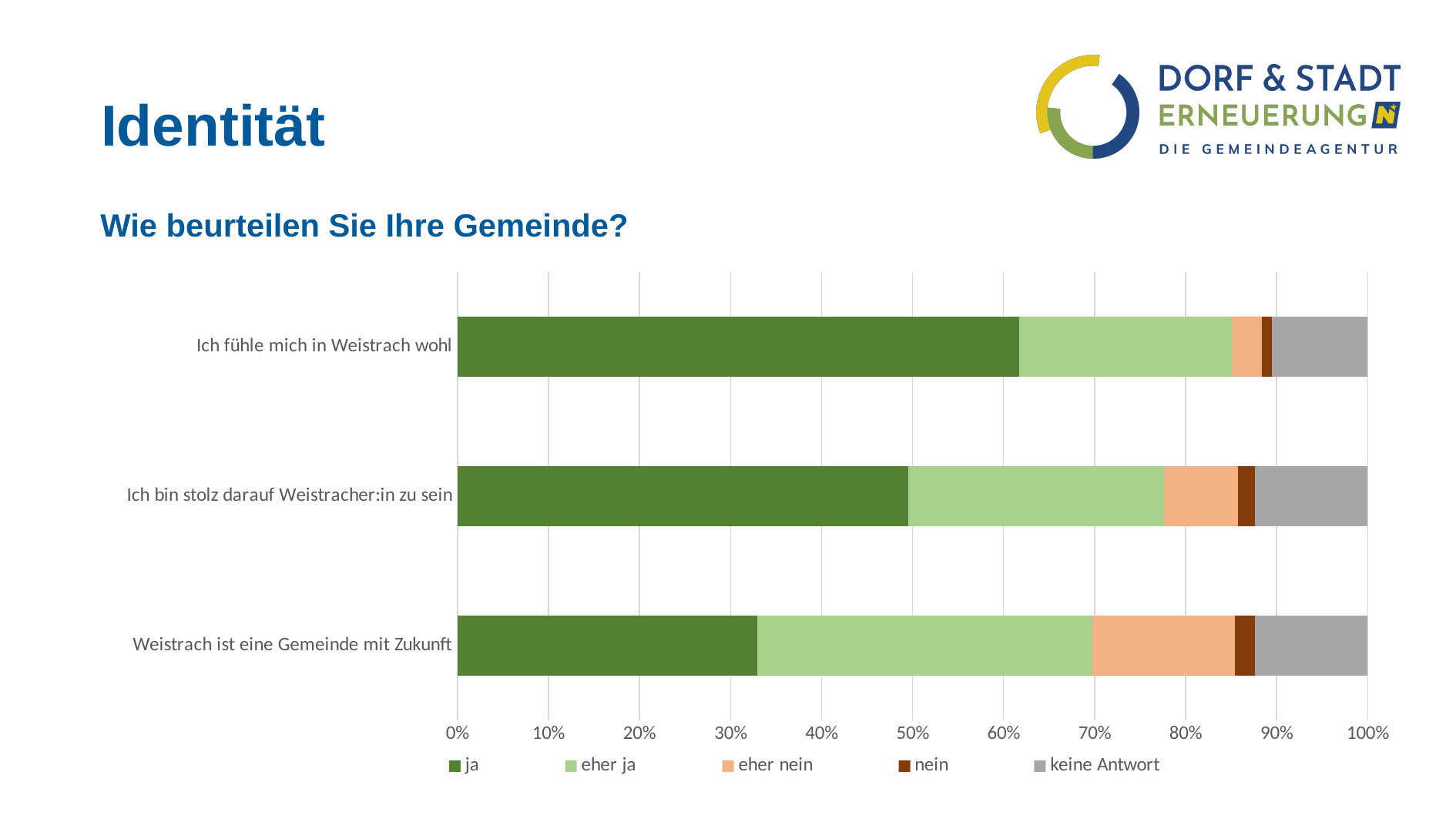
What question is shown as the heading above the chart? Wie beurteilen Sie Ihre Gemeinde? Which statement has the smallest "ja" segment? Weistrach ist eine Gemeinde mit Zukunft How many categories (statements) are plotted in the chart? 3 What is the total of the stacked bar for "Ich bin stolz darauf Weistracher:in zu sein"? 100% Which statement has a larger "eher nein" segment: "Weistrach ist eine Gemeinde mit Zukunft" or "Ich fühle mich in Weistrach wohl"? Weistrach ist eine Gemeinde mit Zukunft Is the "ja" value for "Weistrach ist eine Gemeinde mit Zukunft" greater or less than 40%? less Which statement has the largest "ja" segment? Ich fühle mich in Weistrach wohl Which legend entry is shown in grey? keine Antwort What kind of chart is shown on the slide? stacked bar chart Is the "ja" value for "Weistrach ist eine Gemeinde mit Zukunft" greater or less than 30%? greater Is the "ja" value for "Ich fühle mich in Weistrach wohl" greater or less than 60%? greater How many series does the legend list? 5